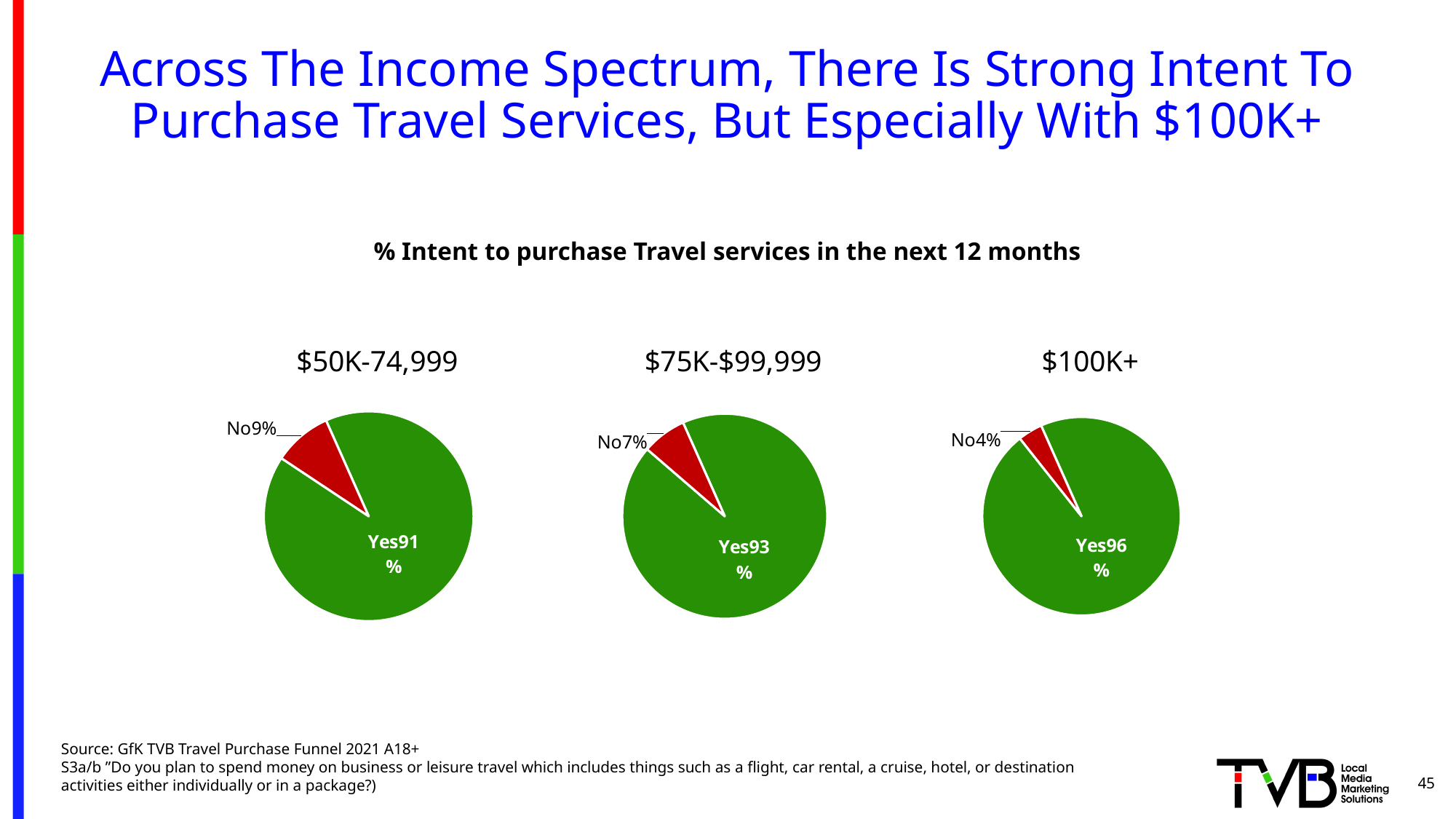
What is the difference between the Yes share in the $100K+ pie chart and the Yes share in the $50K-74,999 pie chart? 5 percentage points Across the three pie charts, which income group has the highest Yes share? $100K+ What colour is the Yes slice in the pie charts? Green In the $50K-74,999 pie chart, what percentage answered No? 9% In the $75K-$99,999 pie chart, what percentage answered No? 7% In the $100K+ pie chart, what percentage answered Yes? 96% Is the No share larger in the $75K-$99,999 pie chart or the $100K+ pie chart? $75K-$99,999 What kind of charts are shown on the slide? Pie charts Across the three pie charts, which income group has the lowest Yes share? $50K-74,999 How many pie charts are on the slide? 3 In the $50K-74,999 pie chart, what percentage answered Yes? 91% How many slices does each pie chart have? 2